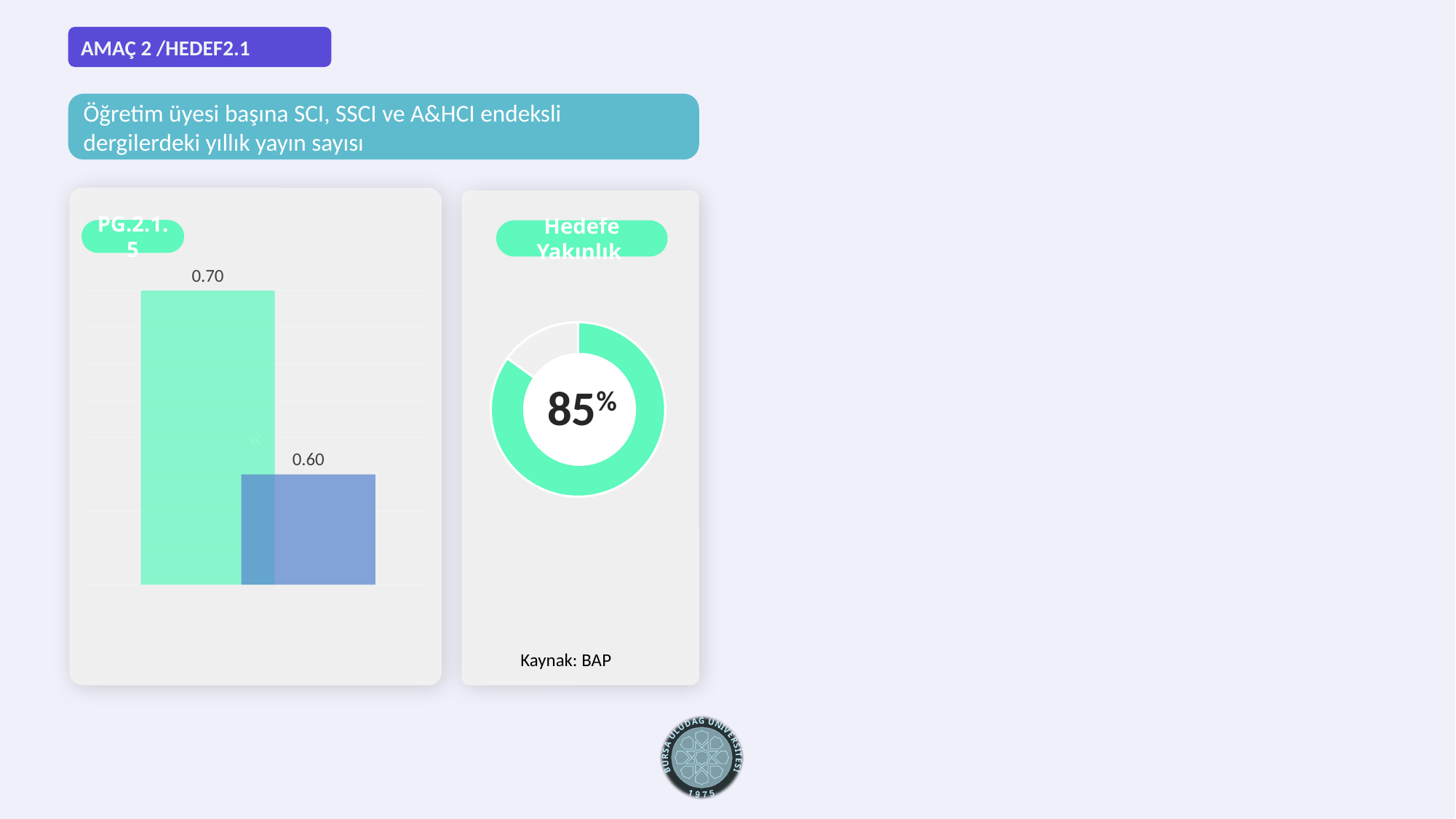
What percentage is shown in the centre of the donut chart under 'Hedefe Yakınlık'? 85% What is the label in the pill at the top of the left bar chart panel? PG.2.1.5 What kind of chart is shown in the left panel labelled PG.2.1.5? bar chart In the bar chart on the left, what value is printed above the green bar? 0.70 In the bar chart on the left, what is the difference between the green bar's value and the blue bar's value? 0.10 What is the source noted below the 'Hedefe Yakınlık' donut chart? Kaynak: BAP In the 'Hedefe Yakınlık' donut chart, what share of the ring is filled in green? 85% How many bars are plotted in the bar chart on the left? 2 In the bar chart on the left, what value is printed above the blue bar? 0.60 In the bar chart on the left, which bar is taller, the green one or the blue one? the green one What kind of chart is shown in the 'Hedefe Yakınlık' panel? donut chart